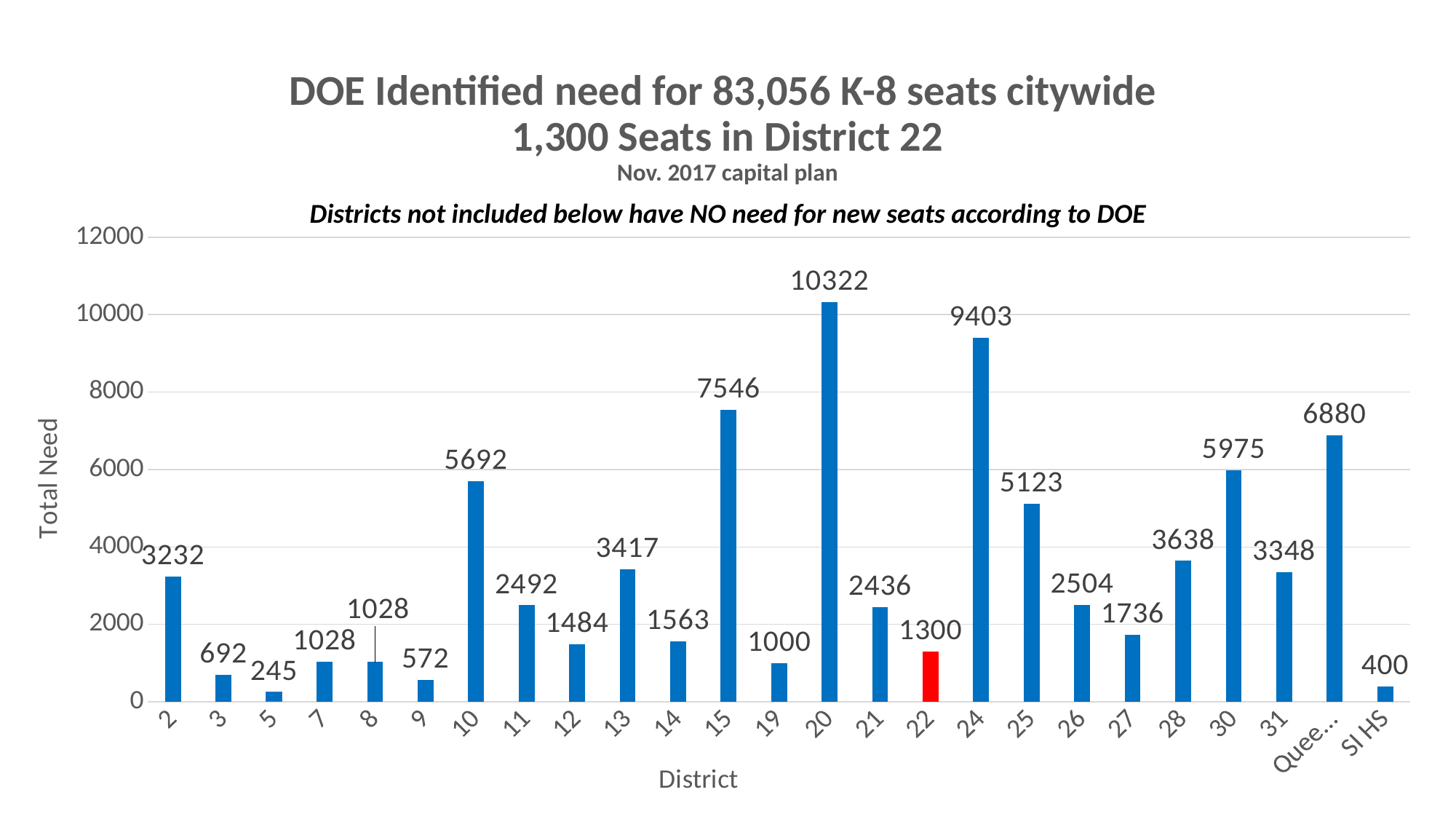
What type of chart is shown on the slide? Bar chart Which district's bar is coloured red instead of blue? 22 What is the total need value shown for District 15? 7546 What is the difference in total need between District 20 and District 24? 919 What is the difference in total need between District 22 and District 19? 300 What is the total need value shown for SI HS? 400 How many districts (bars) are shown on the chart? 25 What is the total need value shown for District 22? 1300 Is the value for District 25 greater or less than 4000? greater Which district has the lowest total need? 5 Which district has the highest total need? 20 Which has a larger total need, District 10 or District 30? District 30